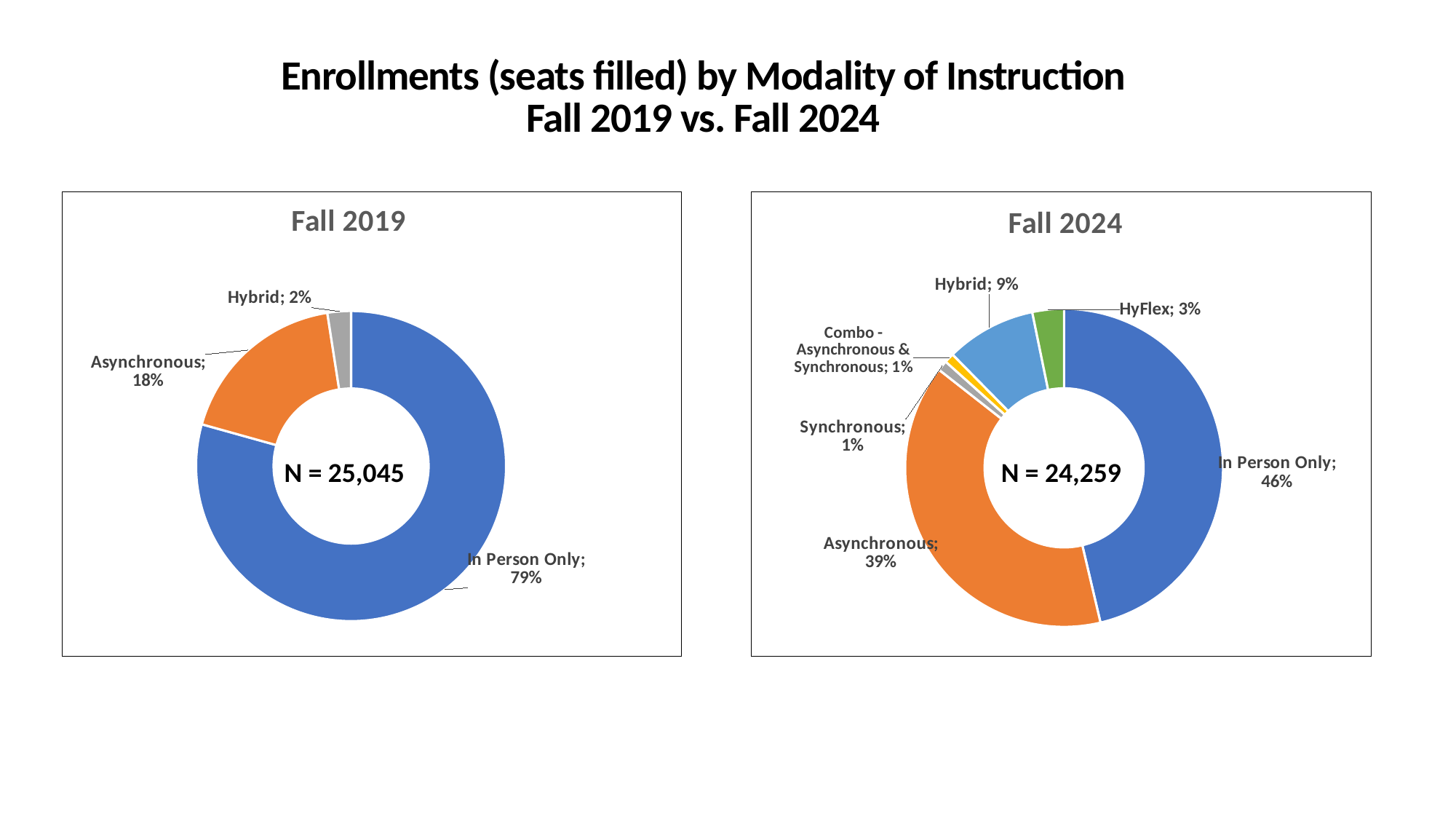
In the Fall 2019 chart, which modality has the smallest share? Hybrid In the Fall 2024 chart, which modality has the largest share? In Person Only How many modality categories are shown in the Fall 2019 chart? 3 In the Fall 2019 chart, what share of enrollments is Asynchronous? 18% How many modality categories are shown in the Fall 2024 chart? 6 What kind of chart is the Fall 2019 chart? Doughnut chart What is the N value shown in the center of the Fall 2024 chart? N = 24,259 In the Fall 2024 chart, what is the difference in percentage points between In Person Only and Asynchronous? 7 In the Fall 2019 chart, what share of enrollments is In Person Only? 79% In the Fall 2024 chart, what share of enrollments is Hybrid? 9% In the Fall 2024 chart, what share of enrollments is HyFlex? 3% In the Fall 2024 chart, which is larger, the Hybrid share or the HyFlex share? Hybrid